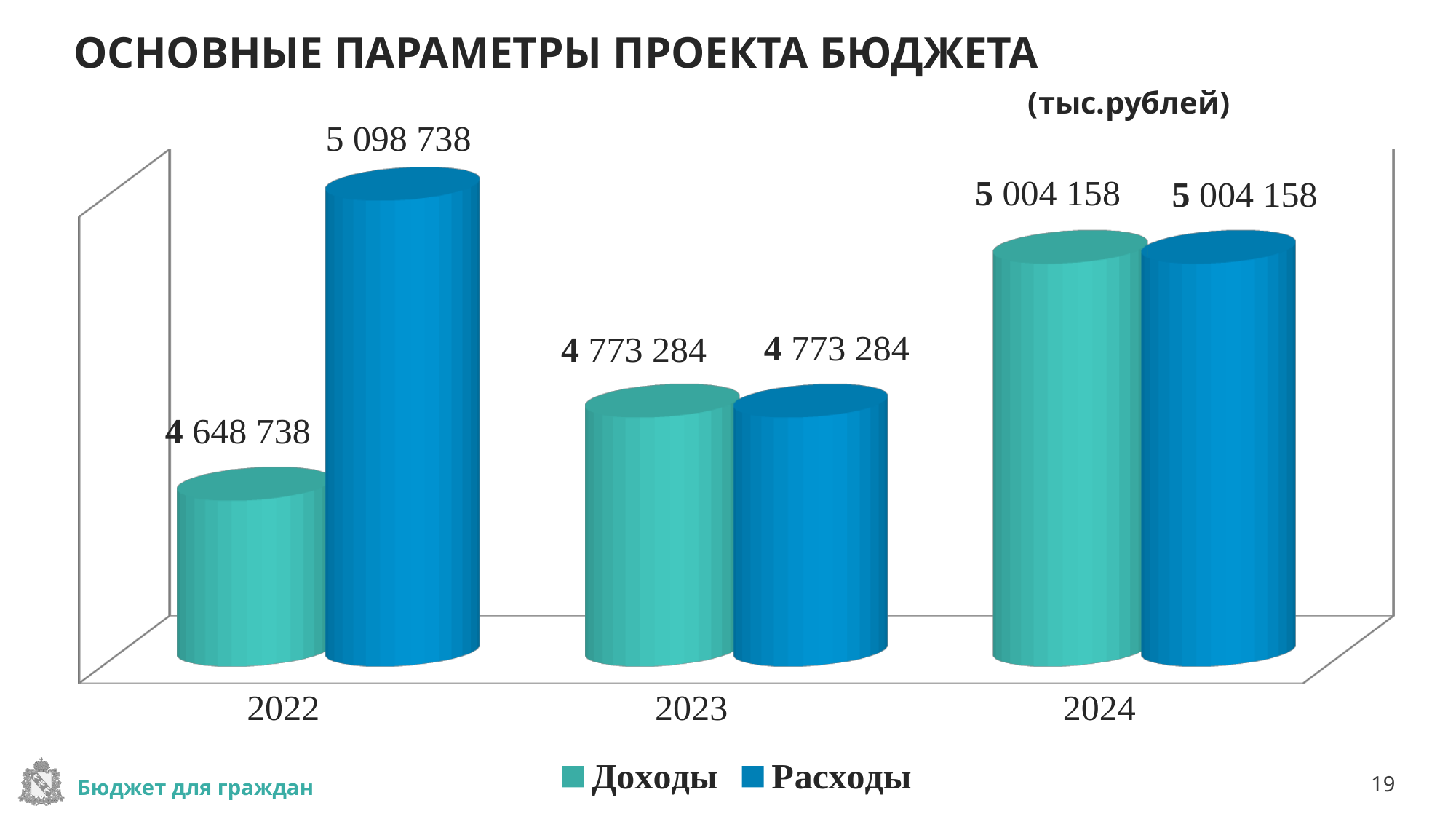
In which year is Расходы the highest? 2022 Which is larger in 2022, Доходы or Расходы? Расходы How many series does the legend list? 2 In which year is Доходы the lowest? 2022 What kind of chart is shown on the slide? Bar chart By how much does Доходы in 2024 exceed Доходы in 2023? 230 874 How many years are shown on the x axis? 3 What is the value of Расходы for 2024? 5 004 158 What is the value of Доходы for 2022? 4 648 738 What is the difference between Расходы and Доходы in 2022? 450 000 What is the value of Расходы for 2022? 5 098 738 What is the value of Доходы for 2023? 4 773 284